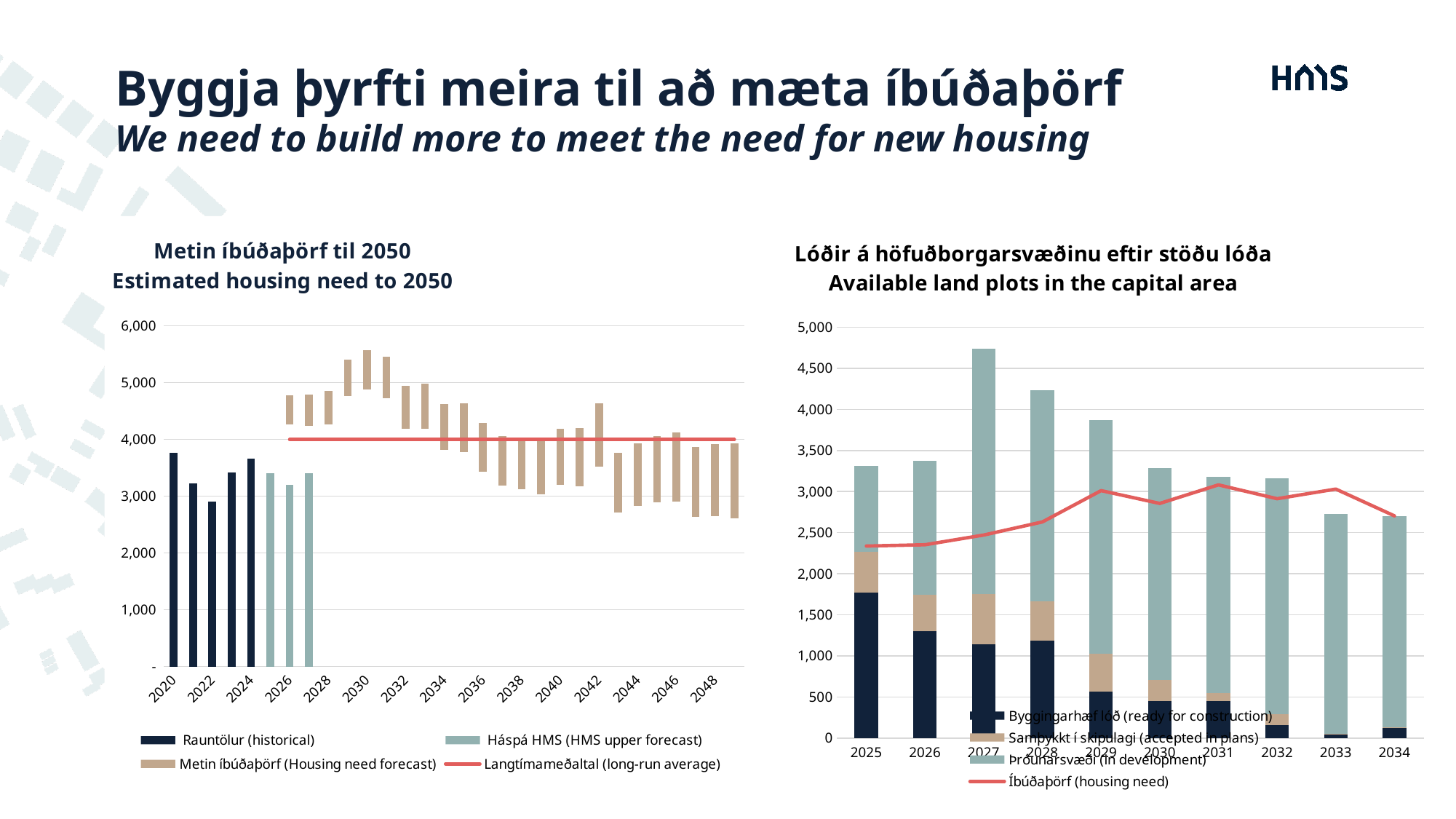
In the 'Available land plots in the capital area' chart, which year has the larger 'ready for construction' segment, 2025 or 2034? 2025 In the 'Estimated housing need to 2050' chart, which year has the taller historical bar, 2020 or 2022? 2020 In the 'Available land plots in the capital area' chart, which year has the tallest stacked bar? 2027 How many entries does the legend of the 'Available land plots in the capital area' chart list? 4 How many years are shown on the x axis of the 'Available land plots in the capital area' chart? 10 In the 'Available land plots in the capital area' chart, is the 'ready for construction' segment for 2025 greater or less than 1,500? greater How many entries does the legend of the 'Estimated housing need to 2050' chart list? 4 In the 'Available land plots in the capital area' chart, does the housing need line rise or fall from 2025 to 2029? rise In the 'Estimated housing need to 2050' chart, what colour are the 'Rauntölur (historical)' bars? dark navy In the 'Available land plots in the capital area' chart, is the total bar for 2034 greater or less than 3,000? less In the 'Available land plots in the capital area' chart, is the total bar for 2027 greater or less than 4,500? greater What type of chart is the 'Available land plots in the capital area' chart? stacked bar chart with a line (combination bar and line chart)